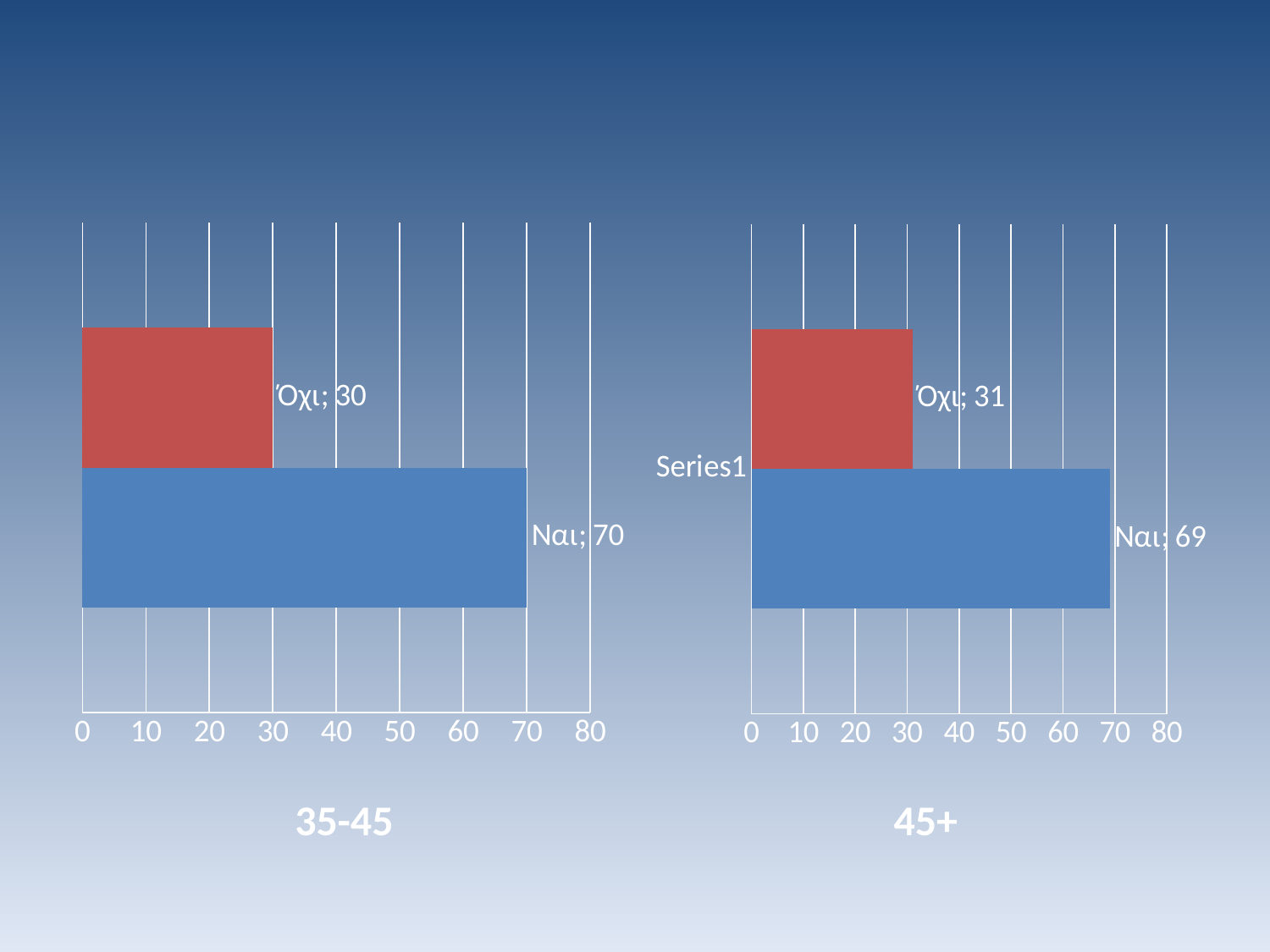
In the 45+ chart, what is the value for Ναι? 69 In the 35-45 chart, what is the value for Ναι? 70 In the 45+ chart, is the value for Ναι greater or less than 60? greater In the 35-45 chart, what is the difference between the Ναι and Όχι values? 40 In the 35-45 chart, which series has the higher value? Ναι In the 45+ chart, which series has the lower value? Όχι What kind of chart is the 35-45 chart? bar chart In the 35-45 chart, what is the value for Όχι? 30 Is the Ναι value in the 35-45 chart larger or smaller than the Ναι value in the 45+ chart? larger In the 45+ chart, what is the value for Όχι? 31 In the 45+ chart, what is the difference between the Ναι and Όχι values? 38 What is the highest value shown on the horizontal axis of the 45+ chart? 80